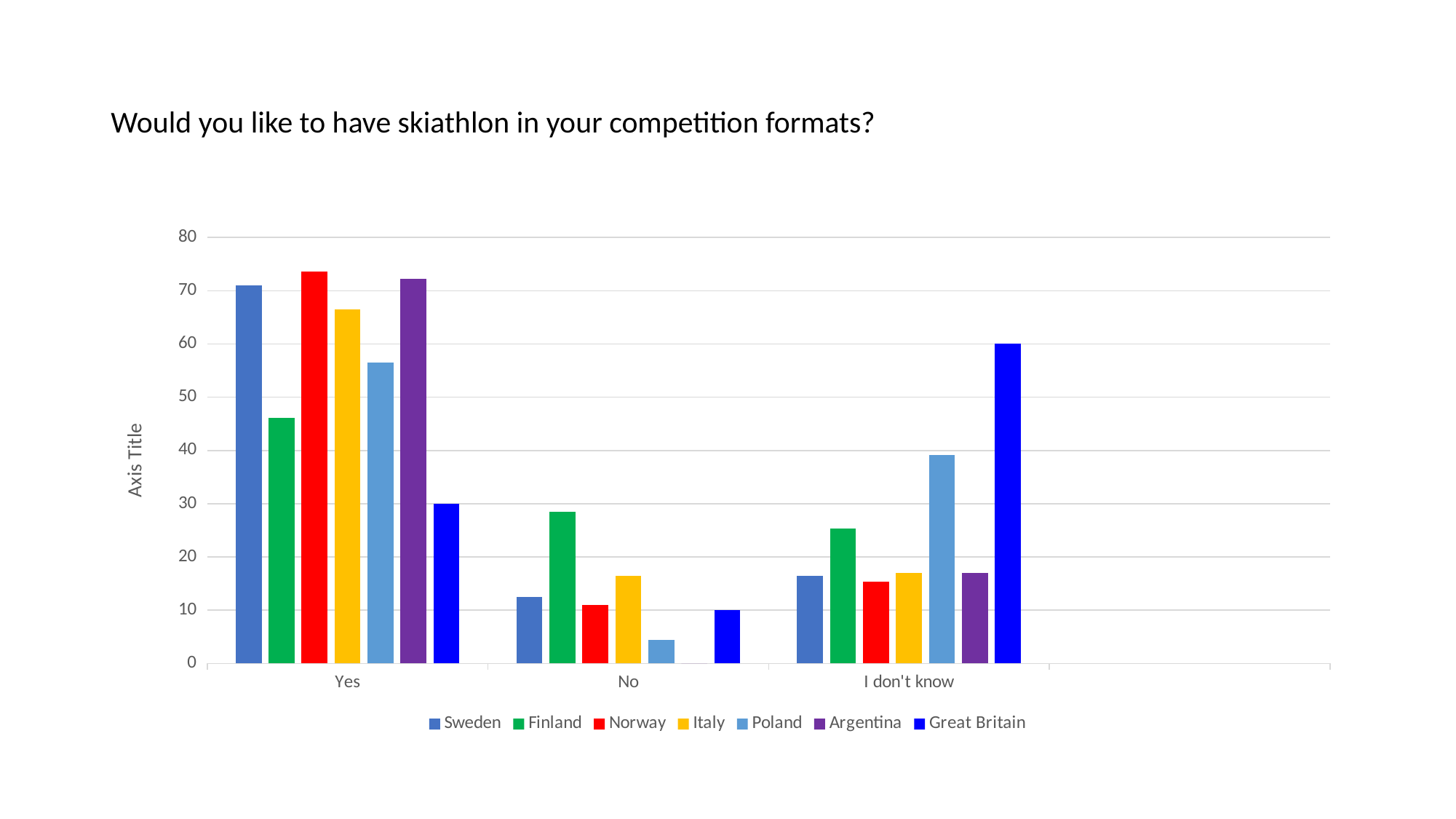
What type of chart is shown on the slide? bar chart Which is larger: Poland's value for 'Yes' or Poland's value for 'I don't know'? Yes What is the title of the chart? Would you like to have skiathlon in your competition formats? How many series does the legend list? 7 Is the value for Italy in the 'Yes' category greater or less than 60? greater Which country has the lowest value in the 'Yes' category? Great Britain How many categories are shown on the x axis? 3 Which country has the highest value in the 'I don't know' category? Great Britain Which country has the highest value in the 'No' category? Finland Is the value for Sweden in the 'No' category greater or less than 10? greater Is the value for Finland in the 'Yes' category greater or less than 40? greater Which country has the lowest value in the 'No' category? Argentina